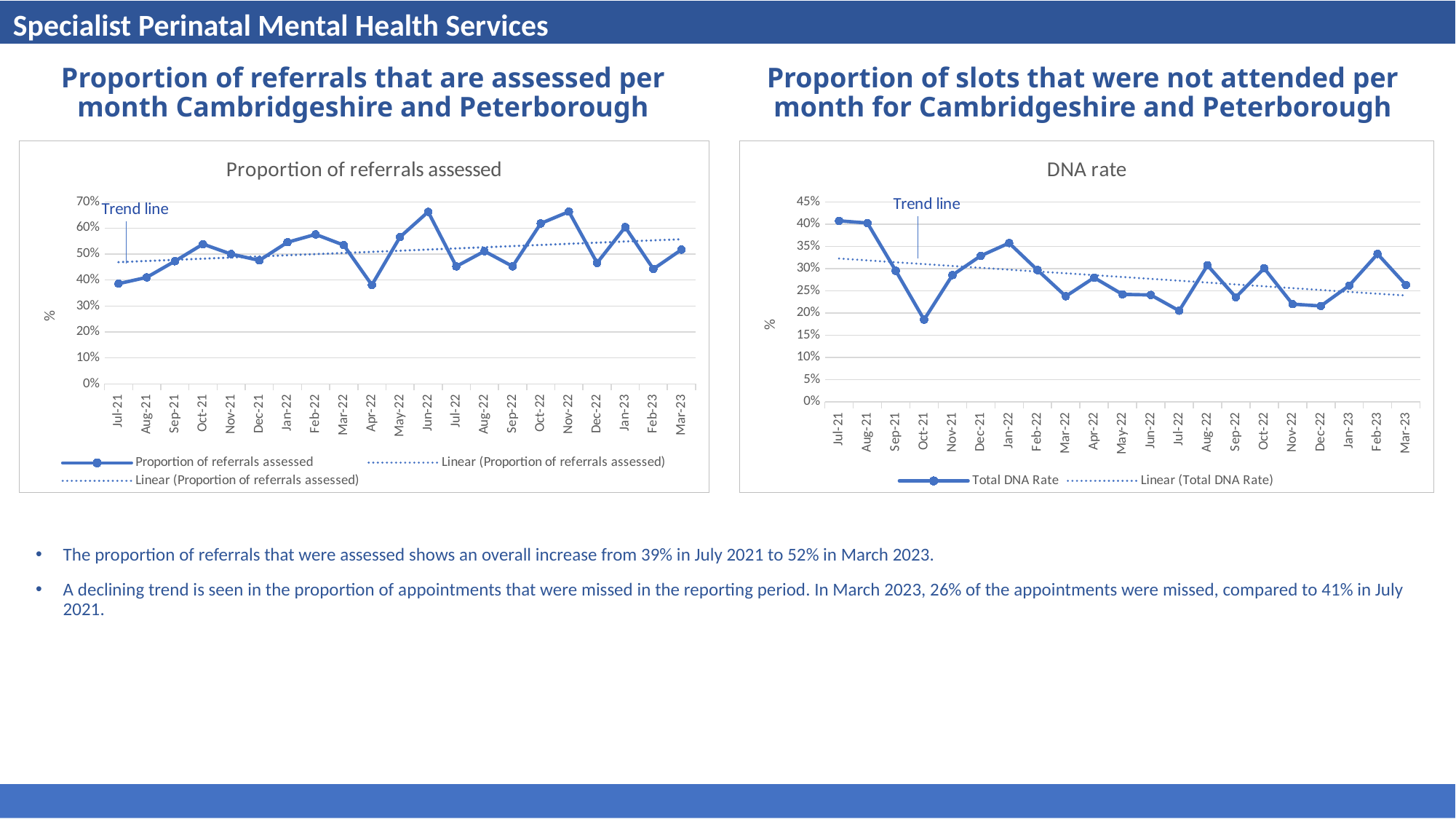
In the 'DNA rate' chart, is the value for Jul-22 greater or less than 25%? less In the 'Proportion of referrals assessed' chart, is the value for Jun-22 greater or less than 60%? greater How many months are plotted on the x axis of the 'Proportion of referrals assessed' chart? 21 Does the trend line in the 'DNA rate' chart rise or fall from Jul-21 to Mar-23? fall In the 'DNA rate' chart, which is larger, the value for Jul-21 or the value for Oct-21? Jul-21 According to the slide, what was the proportion of referrals assessed in March 2023? 52% In the 'Proportion of referrals assessed' chart, is the value for Apr-22 greater or less than 40%? less How many entries does the legend of the 'Proportion of referrals assessed' chart list? 3 What type of chart is the 'Proportion of referrals assessed' chart on the left? line chart In the 'DNA rate' chart on the right, which month has the lowest DNA rate? Oct-21 How many entries does the legend of the 'DNA rate' chart list? 2